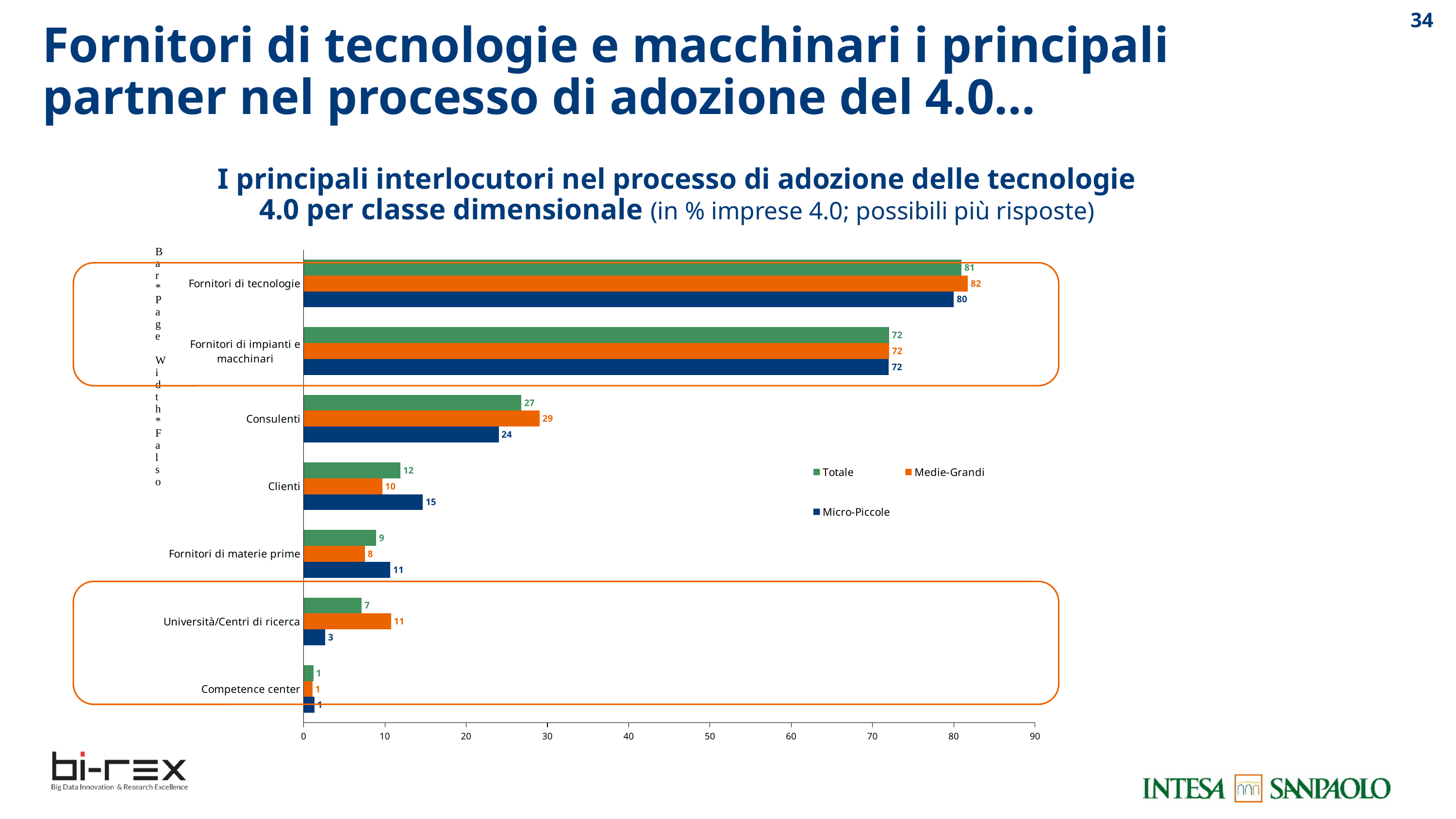
What is the difference between the Medie-Grandi and Micro-Piccole values for Consulenti? 5 Which category has the lowest Micro-Piccole value? Competence center What is the Totale value for Clienti? 12 Which series is shown in orange in the legend? Medie-Grandi Which category has the highest Totale value? Fornitori di tecnologie How many categories are shown on the chart? 7 What kind of chart is shown on the slide? Bar chart What is the Medie-Grandi value for Università/Centri di ricerca? 11 How many series does the legend list? 3 What is the Medie-Grandi value for Fornitori di tecnologie? 82 For Clienti, which is larger: the Micro-Piccole value or the Medie-Grandi value? Micro-Piccole What is the Micro-Piccole value for Consulenti? 24